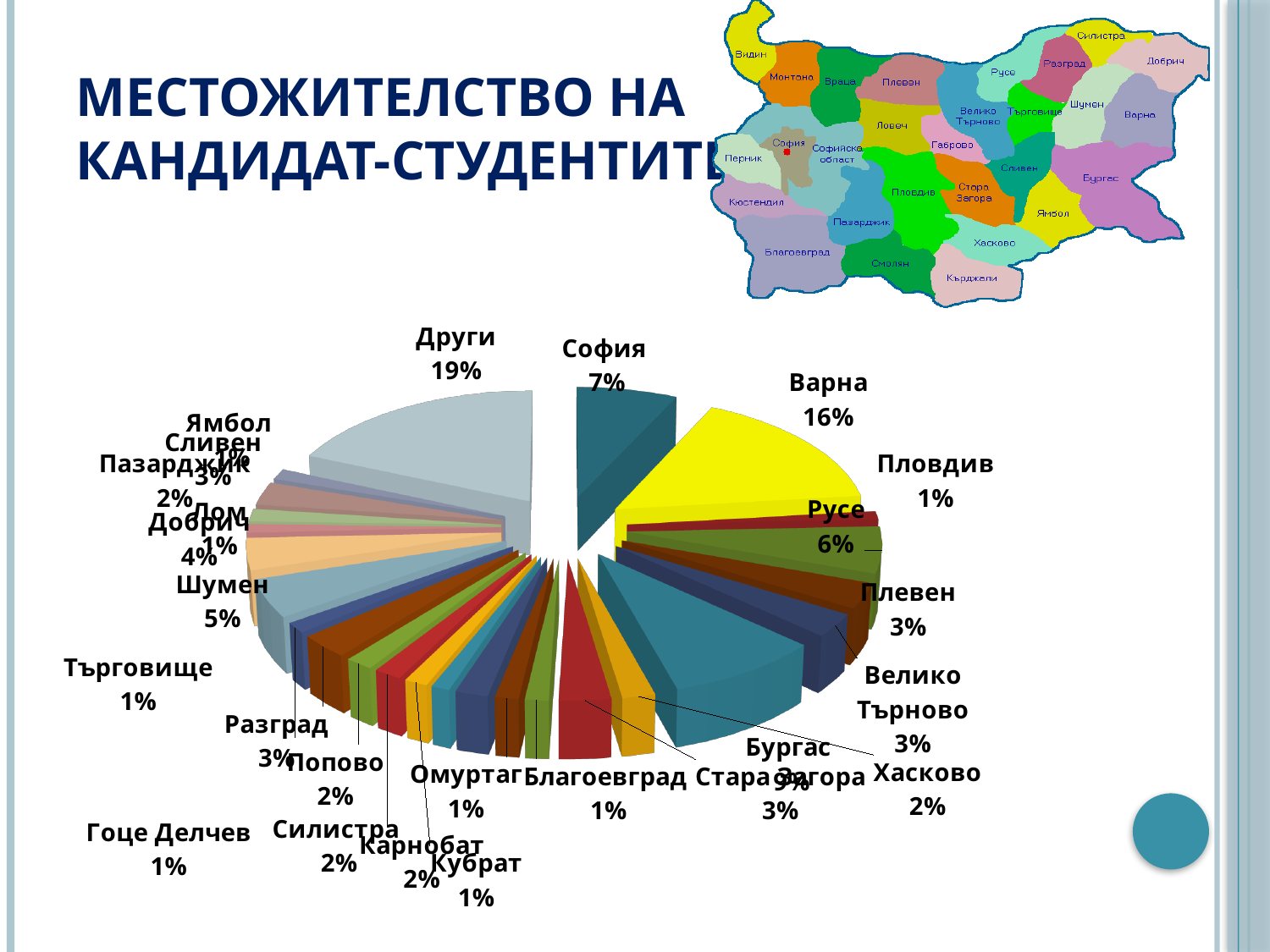
What is the value shown for Добрич? 4% What kind of chart is shown on the slide? pie chart What is the value shown for Русе? 6% What is the title of the slide containing the pie chart? МЕСТОЖИТЕЛСТВО НА КАНДИДАТ-СТУДЕНТИТЕ What share of the pie does Варна have? 16% What is the value shown for София? 7% What is the value shown for Шумен? 5% What is the difference between the shares for Варна and София? 9% What is the difference between the shares for Бургас and Русе? 3% What is the value shown for Бургас? 9% Which is larger, the share for Варна or the share for София? Варна Which slice of the pie is the largest? Други